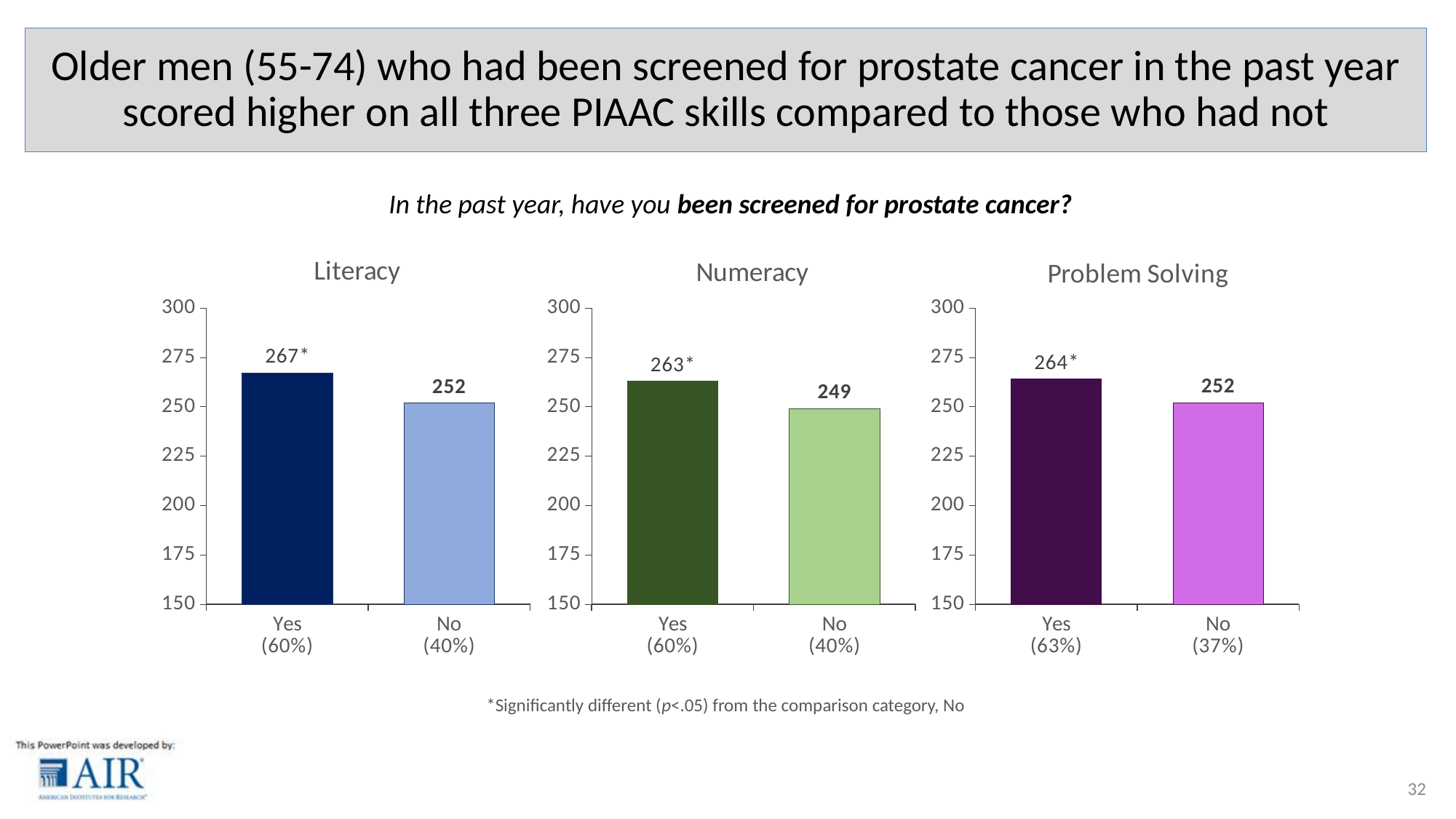
In the Numeracy chart, what is the value for Yes (60%)? 263 In the Literacy chart, what is the value for Yes (60%)? 267 In the Numeracy chart, which category has the lowest value? No (40%) In the Problem Solving chart, what is the value for Yes (63%)? 264 What type of chart is the Problem Solving chart? Bar chart In the Numeracy chart, what is the difference between the Yes and No values? 14 How many bars are in the Literacy chart? 2 In the Problem Solving chart, which category has the higher value, Yes or No? Yes In the Literacy chart, what is the value for No (40%)? 252 In the Numeracy chart, what is the value for No (40%)? 249 In the Literacy chart, what is the difference between the Yes and No values? 15 In the Problem Solving chart, what is the value for No (37%)? 252